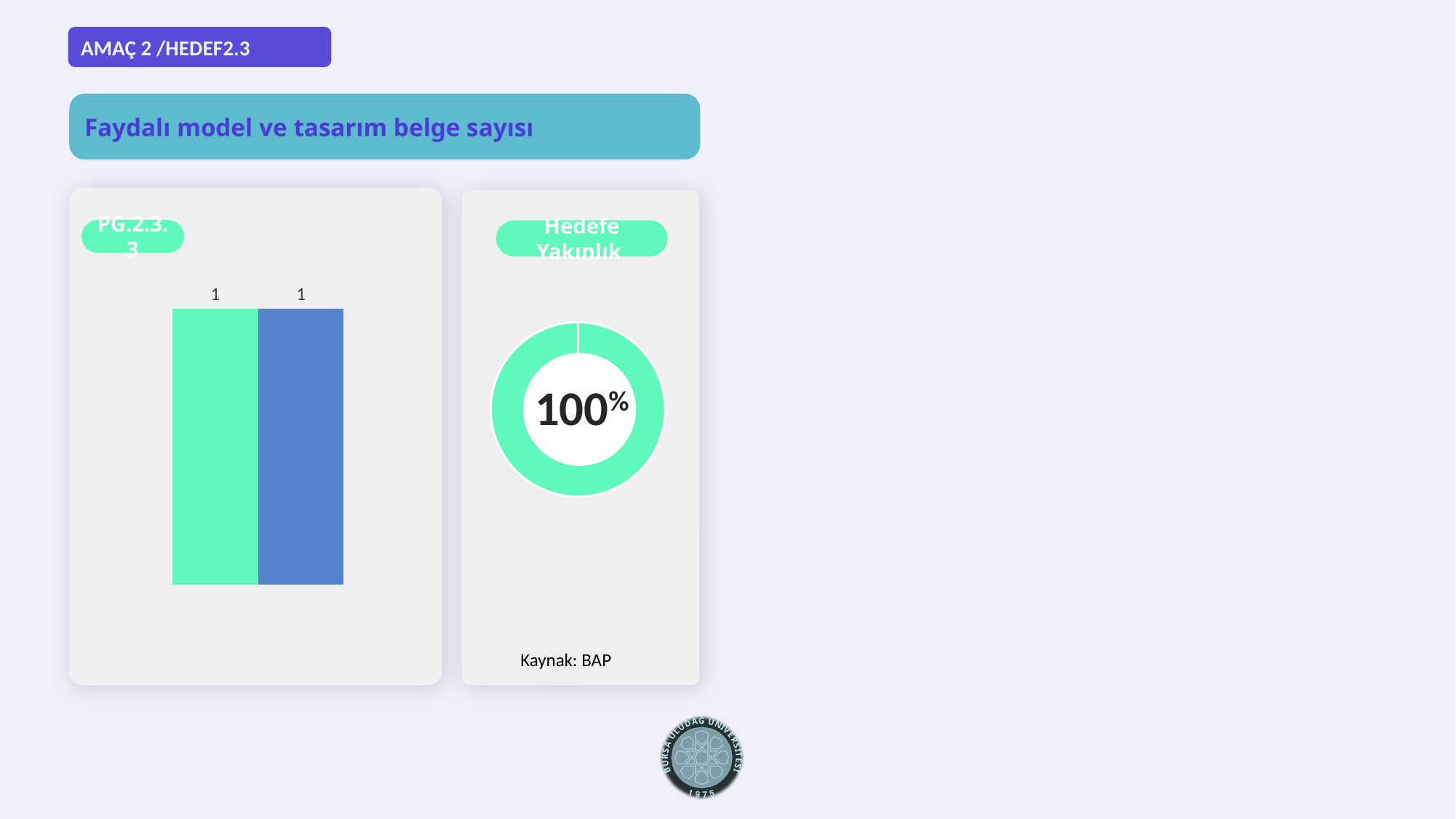
In the bar chart on the left, what is the value shown above the blue bar? 1 What percentage is displayed in the centre of the donut chart under 'Hedefe Yakınlık'? 100% What source is cited below the donut chart? Kaynak: BAP How many bars are plotted in the bar chart on the left? 2 In the bar chart on the left, what is the total of the two bar values? 2 What is the title of the slide's indicator shown in the blue banner? Faydalı model ve tasarım belge sayısı What kind of chart is shown in the left panel labelled PG.2.3.3? bar chart In the bar chart on the left, what is the value shown above the green bar? 1 What kind of chart is shown in the right panel under 'Hedefe Yakınlık'? donut chart In the bar chart on the left, what is the difference between the green bar's value and the blue bar's value? 0